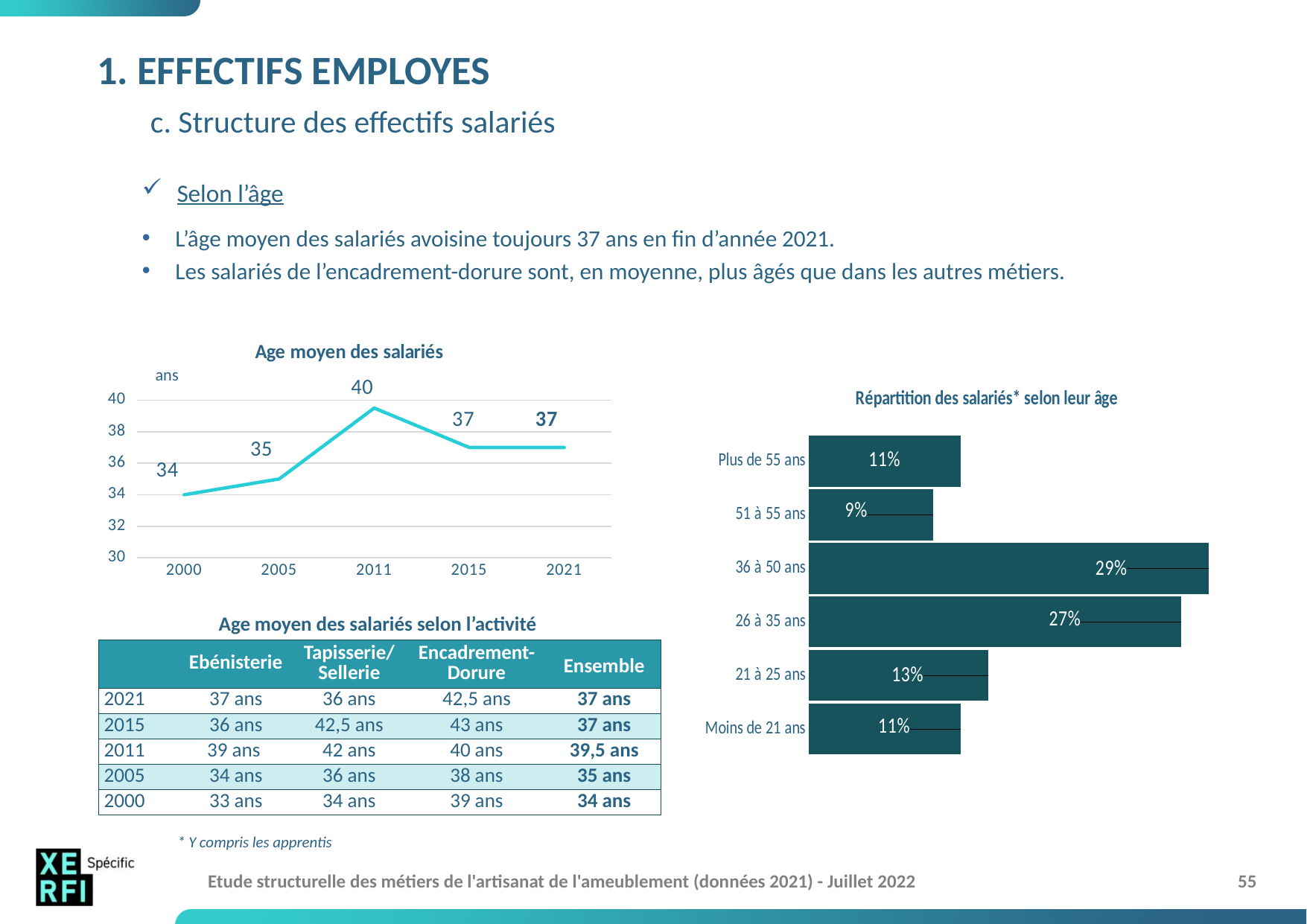
In the 'Répartition des salariés* selon leur âge' chart, what is the value for '36 à 50 ans'? 29% In the 'Age moyen des salariés' chart, what is the value for 2000? 34 In the 'Répartition des salariés* selon leur âge' chart, which age group has the lowest value? 51 à 55 ans In the 'Répartition des salariés* selon leur âge' chart, which is larger: '21 à 25 ans' or 'Moins de 21 ans'? 21 à 25 ans What kind of chart is 'Répartition des salariés* selon leur âge'? Bar chart In the 'Age moyen des salariés' chart, which year has the lowest value? 2000 What kind of chart is 'Age moyen des salariés'? Line chart In the 'Age moyen des salariés' chart, how many data points are plotted? 5 In the 'Répartition des salariés* selon leur âge' chart, what is the difference between '36 à 50 ans' and '26 à 35 ans'? 2% In the 'Age moyen des salariés' chart, what is the value for 2011? 40 In the 'Age moyen des salariés' chart, what is the difference between the values for 2011 and 2005? 5 In the 'Age moyen des salariés' chart, which year has the highest value? 2011